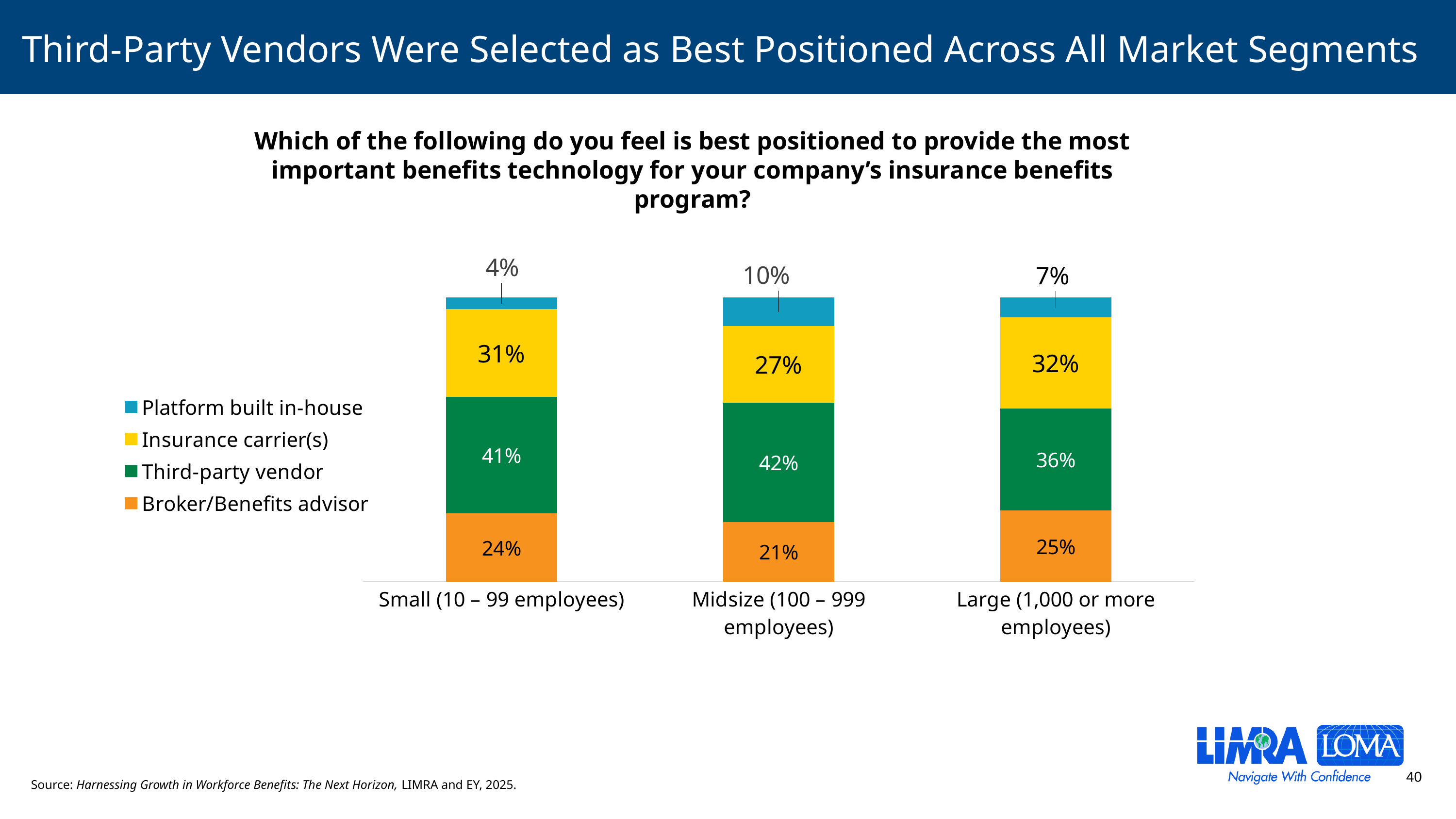
Which legend entry is shown in orange? Broker/Benefits advisor Which market segment has the highest share for Third-party vendor? Midsize (100 – 999 employees) How many market segments are shown on the x axis? 3 Which market segment has the lowest share for Platform built in-house? Small (10 – 99 employees) What kind of chart is shown on the slide? Stacked bar chart What is the difference between the Third-party vendor share for Small and Large companies? 5 percentage points What percentage of Small (10 – 99 employees) companies selected Third-party vendor? 41% Which is larger for Large (1,000 or more employees) companies: Insurance carrier(s) or Third-party vendor? Third-party vendor What percentage of Large (1,000 or more employees) companies selected Platform built in-house? 7% How many series does the legend list? 4 What percentage of Midsize (100 – 999 employees) companies selected Insurance carrier(s)? 27% What percentage of Midsize (100 – 999 employees) companies selected Broker/Benefits advisor? 21%